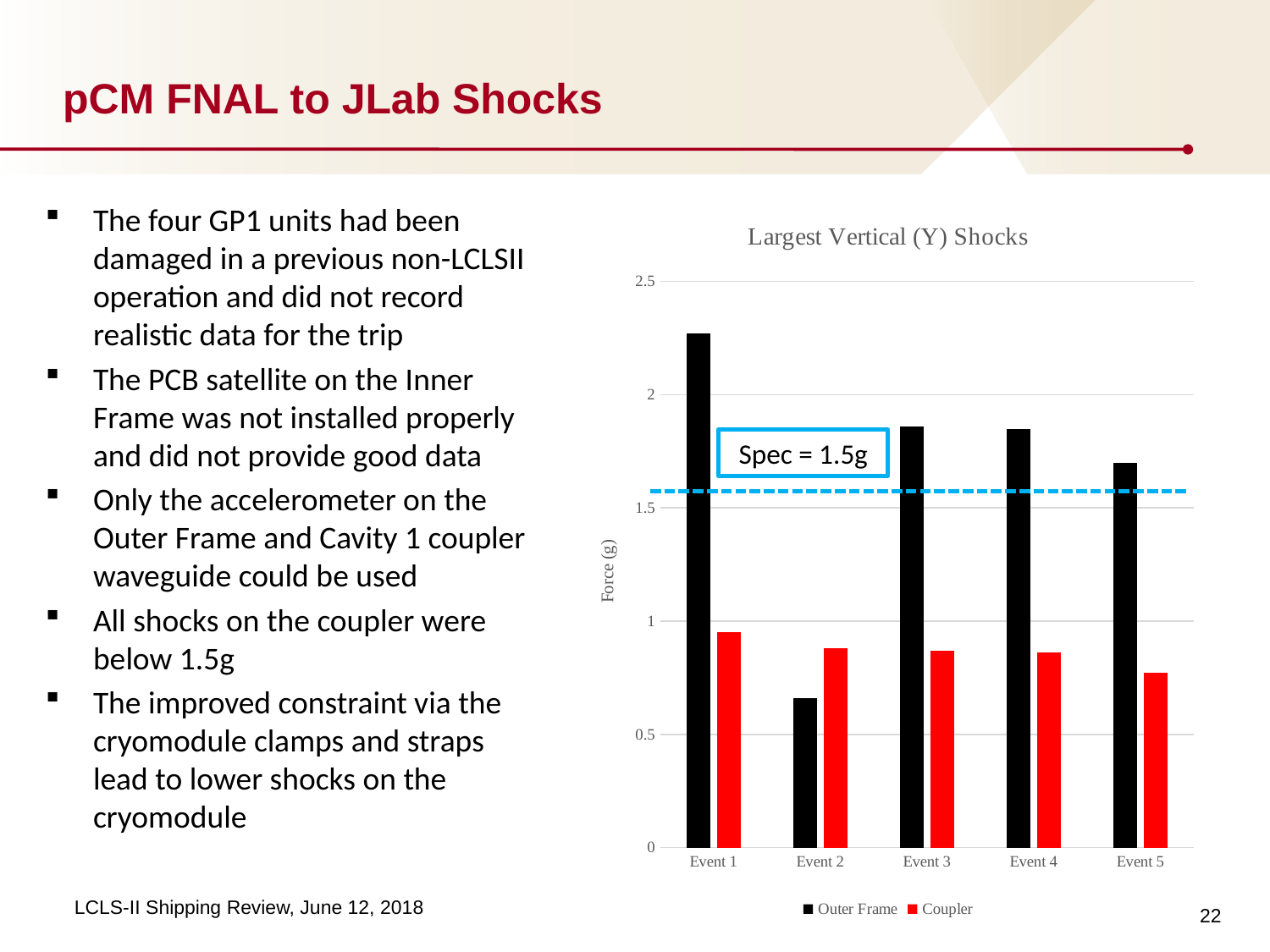
For Event 2, which is larger: the Outer Frame value or the Coupler value? Coupler How many series does the chart legend list? 2 Which event has the lowest Outer Frame value? Event 2 What kind of chart is shown on the slide? Bar chart What spec value is marked by the dashed line on the chart? Spec = 1.5g Is the Coupler value for Event 1 greater or less than 1? less Is the Outer Frame value for Event 1 greater or less than 2? greater Which event has the lowest Coupler value? Event 5 How many events are shown on the x axis of the chart? 5 Is the Outer Frame value for Event 2 greater or less than 1? less Which event has the highest Outer Frame value? Event 1 What is the title of the chart? Largest Vertical (Y) Shocks